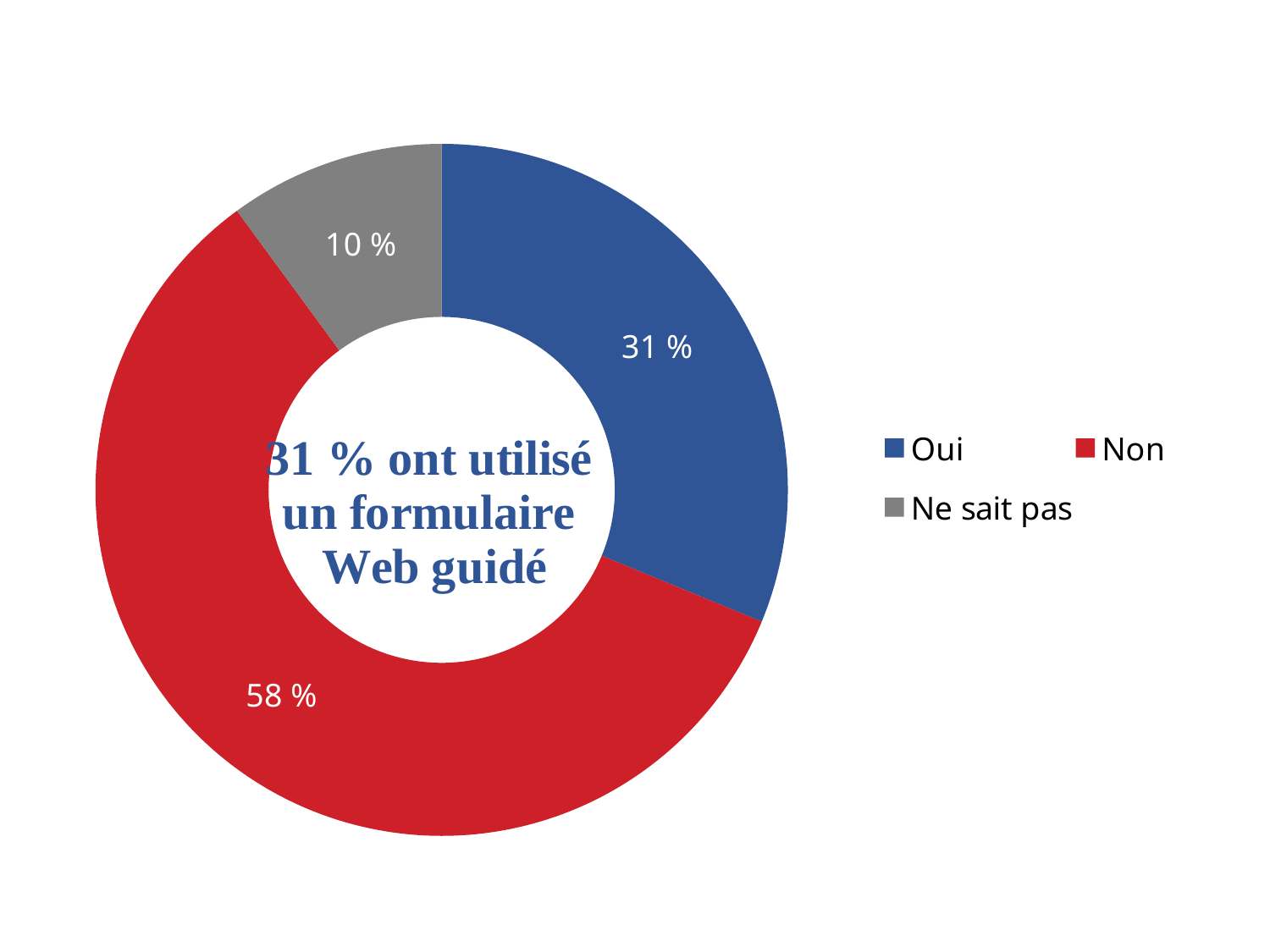
What percentage of the doughnut chart is labelled "Oui"? 31 % Which category has the largest share of the chart? Non What percentage of the doughnut chart is labelled "Ne sait pas"? 10 % How many entries does the legend list? 3 What is the difference in percentage points between the "Non" and "Oui" slices? 27 What text is written in the centre of the doughnut chart? 31 % ont utilisé un formulaire Web guidé Which category has the smallest share of the chart? Ne sait pas What kind of chart is shown on the slide? Doughnut (pie) chart Which slice is larger, "Oui" or "Ne sait pas"? Oui How many categories does the chart show? 3 What percentage of the doughnut chart is labelled "Non"? 58 % What colour is the "Non" slice? Red